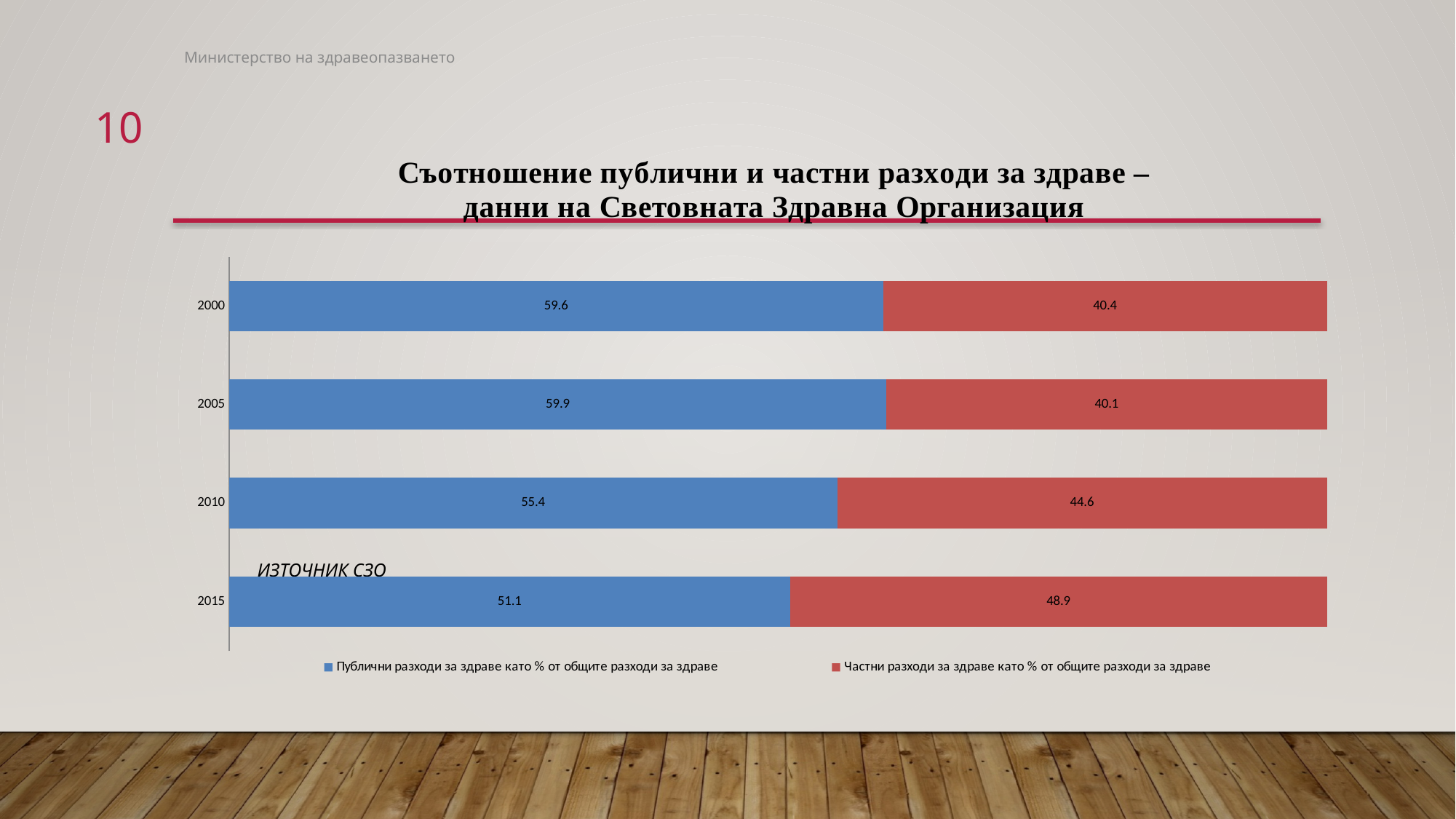
Does the private health expenditure share rise or fall from 2005 to 2015? Rise What is the value of public health expenditure as % of total health expenditure for 2000? 59.6 What is the total of the stacked bar for 2000? 100 In which year is the public health expenditure share the highest? 2005 What is the value of private health expenditure as % of total health expenditure for 2015? 48.9 How many series does the legend list? 2 What kind of chart is shown on the slide? Stacked bar chart What is the difference between the public and private expenditure shares in 2015? 2.2 Which is larger in 2010: the public expenditure share or the private expenditure share? Public expenditure share How many years are shown on the chart? 4 In which year is the public health expenditure share the lowest? 2015 What is the value of private health expenditure as % of total health expenditure for 2010? 44.6